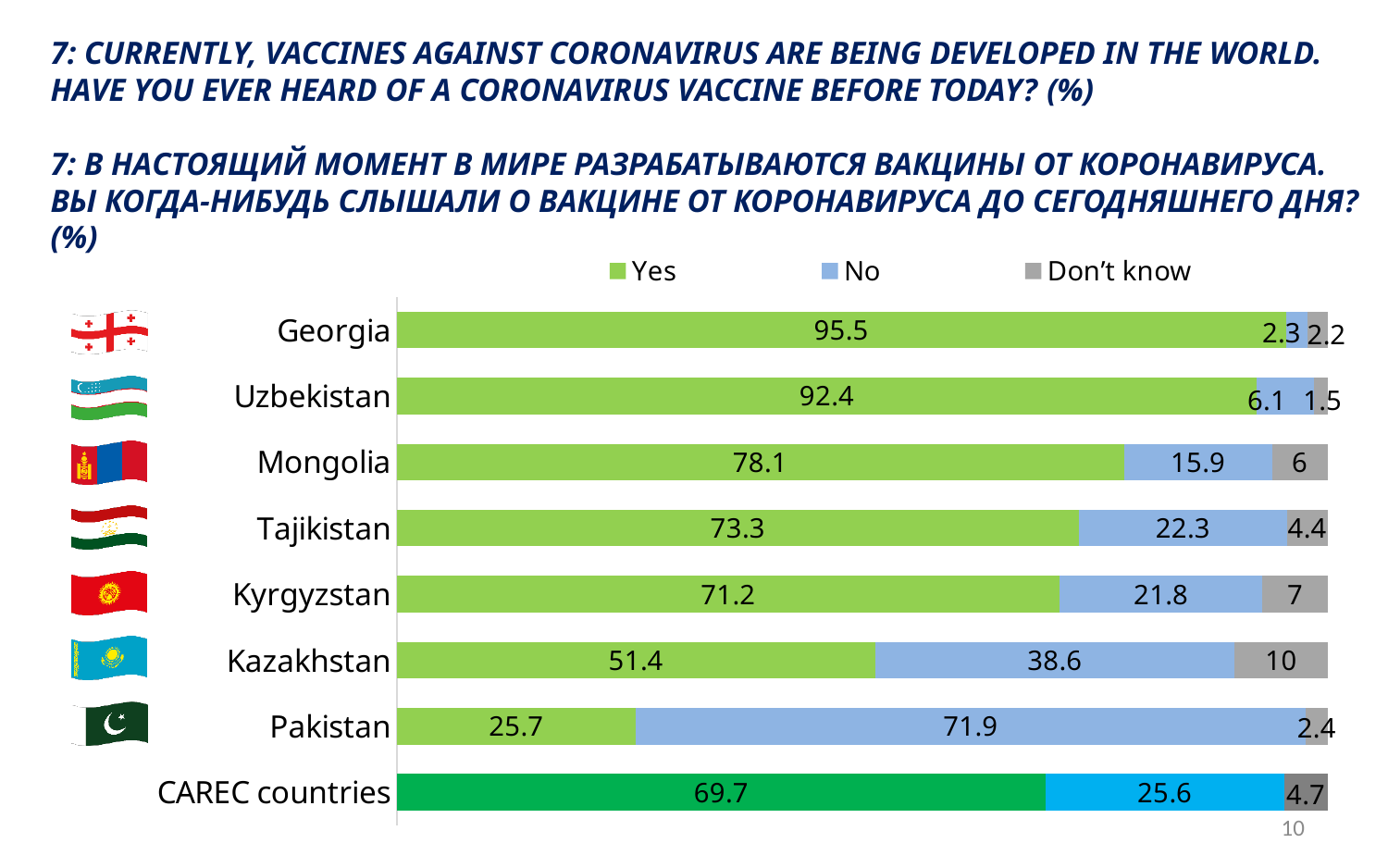
Which country has the highest Yes value? Georgia What is the No value for Kazakhstan? 38.6 What is the difference between the Yes values for Georgia and Uzbekistan? 3.1 What is the Yes value for Pakistan? 25.7 Which has a larger Yes value, Tajikistan or Kyrgyzstan? Tajikistan How many series does the legend list? 3 What is the No value for CAREC countries? 25.6 Which country has the lowest Yes value? Pakistan What percentage of respondents in Georgia answered Yes? 95.5 What type of chart is shown on the slide? Stacked bar chart What is the Don't know value for Mongolia? 6 How many categories (rows) are shown in the chart? 8